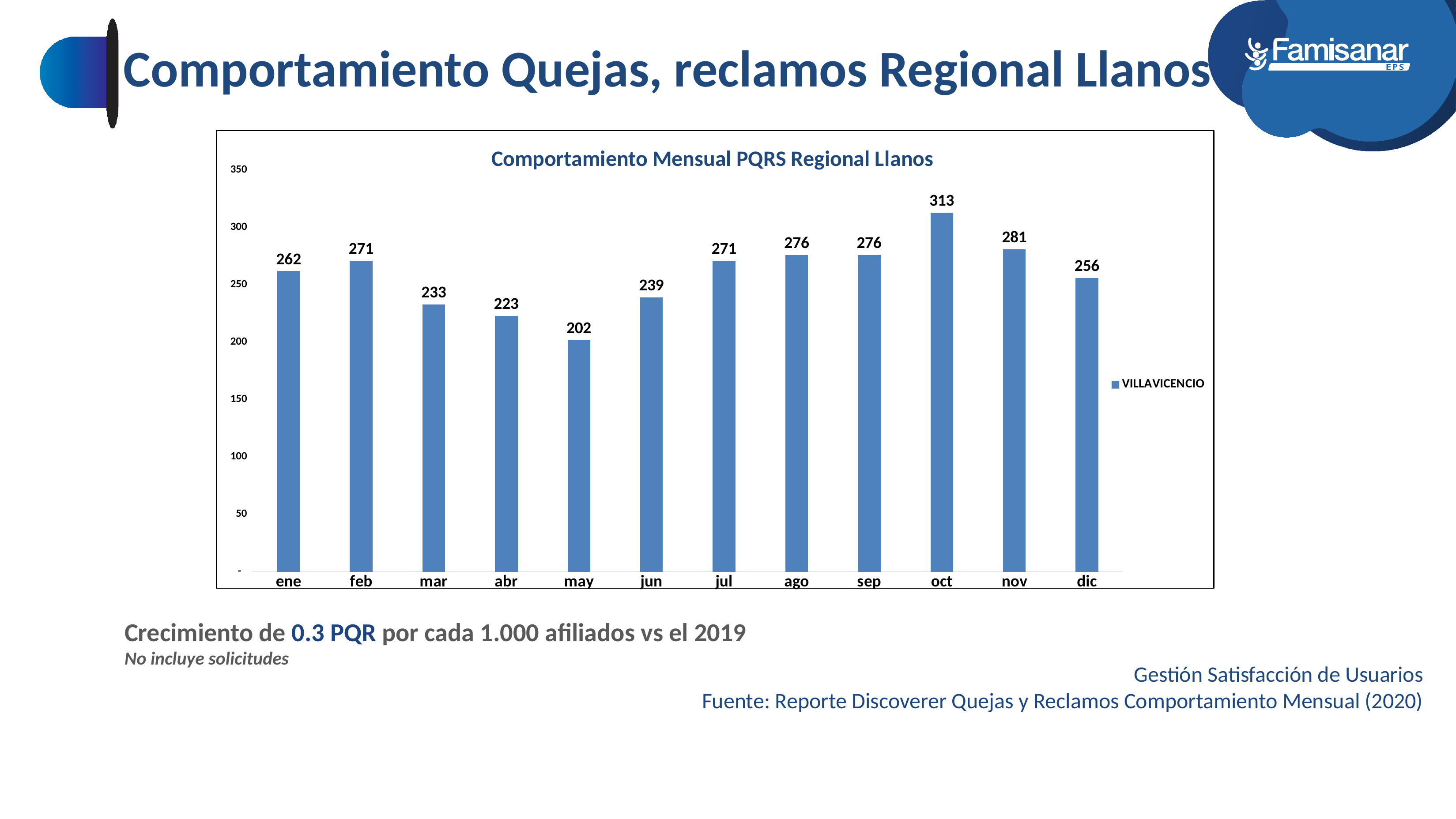
What is the value for may? 202 What is the difference between the values for oct and may? 111 What is the value for oct? 313 What is the value for ene? 262 Which month has the lowest value? may How many months are shown on the x axis? 12 Which is larger, the value for mar or the value for jun? jun What is the difference between the values for nov and dic? 25 Is the value for abr greater or less than 250? less What kind of chart is shown? bar chart Which month has the highest value? oct What series name does the legend show? VILLAVICENCIO